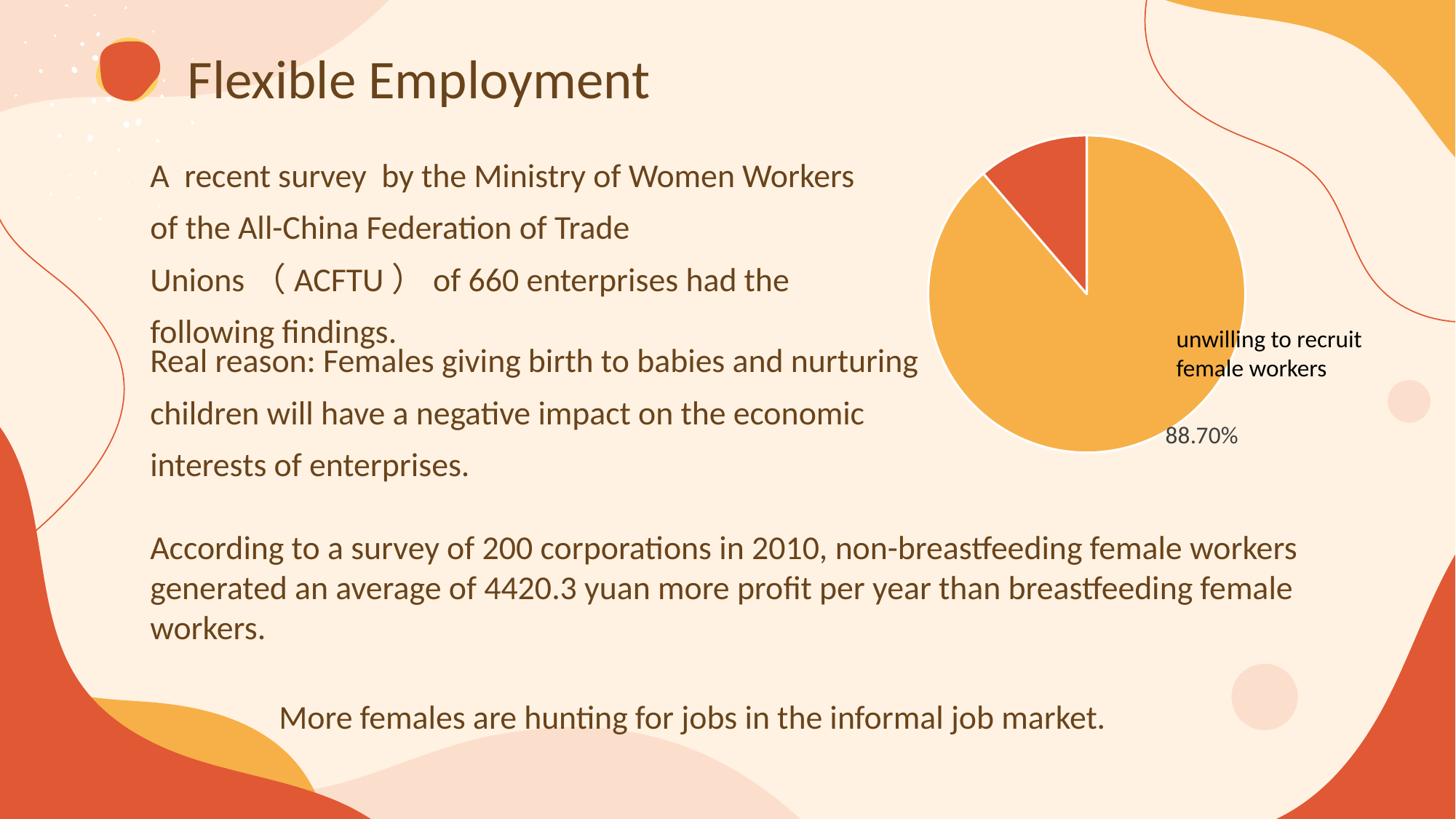
What colour is the largest slice of the pie chart? orange What kind of chart is shown on the slide? pie chart Which slice of the pie chart is the largest? unwilling to recruit female workers What percentage is shown for the slice labelled 'unwilling to recruit female workers'? 88.70% Which slice is larger, the orange slice or the red slice? the orange slice What share of the pie does the 'unwilling to recruit female workers' slice take? 88.70% What is the only data label printed on the pie chart? 88.70% How many slices does the pie chart have? 2